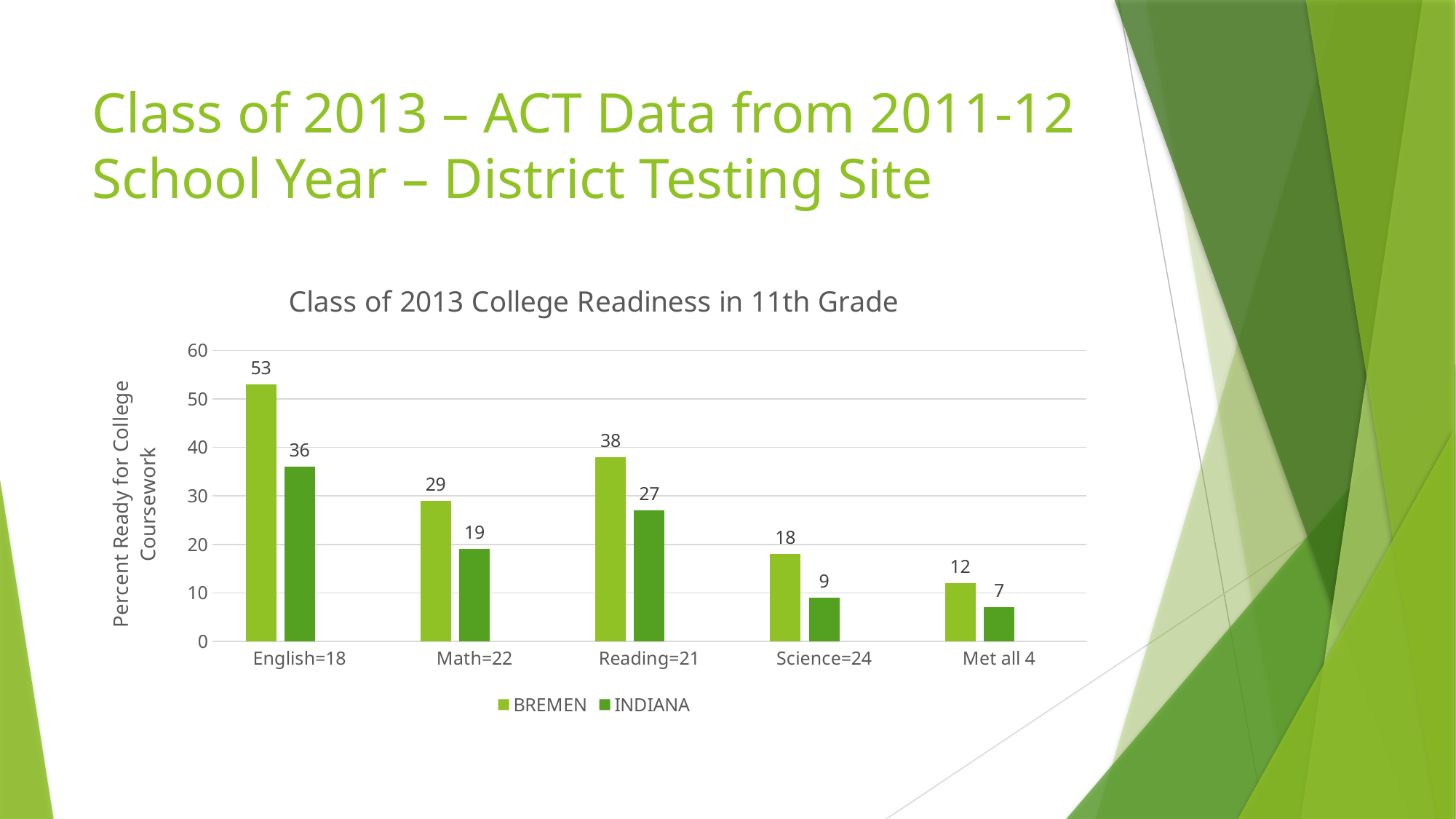
What is the BREMEN value for English=18? 53 What kind of chart is shown? Bar chart What is the title of the chart? Class of 2013 College Readiness in 11th Grade What is the difference between the BREMEN and INDIANA values for Math=22? 10 What is the INDIANA value for Science=24? 9 Which category has the lowest INDIANA value? Met all 4 Do the BREMEN values rise or fall from Reading=21 to Met all 4? Fall How many categories are shown on the x axis? 5 Which category has the highest BREMEN value? English=18 How many series does the legend list? 2 Which is larger for Reading=21, the BREMEN value or the INDIANA value? BREMEN What is the BREMEN value for Reading=21? 38